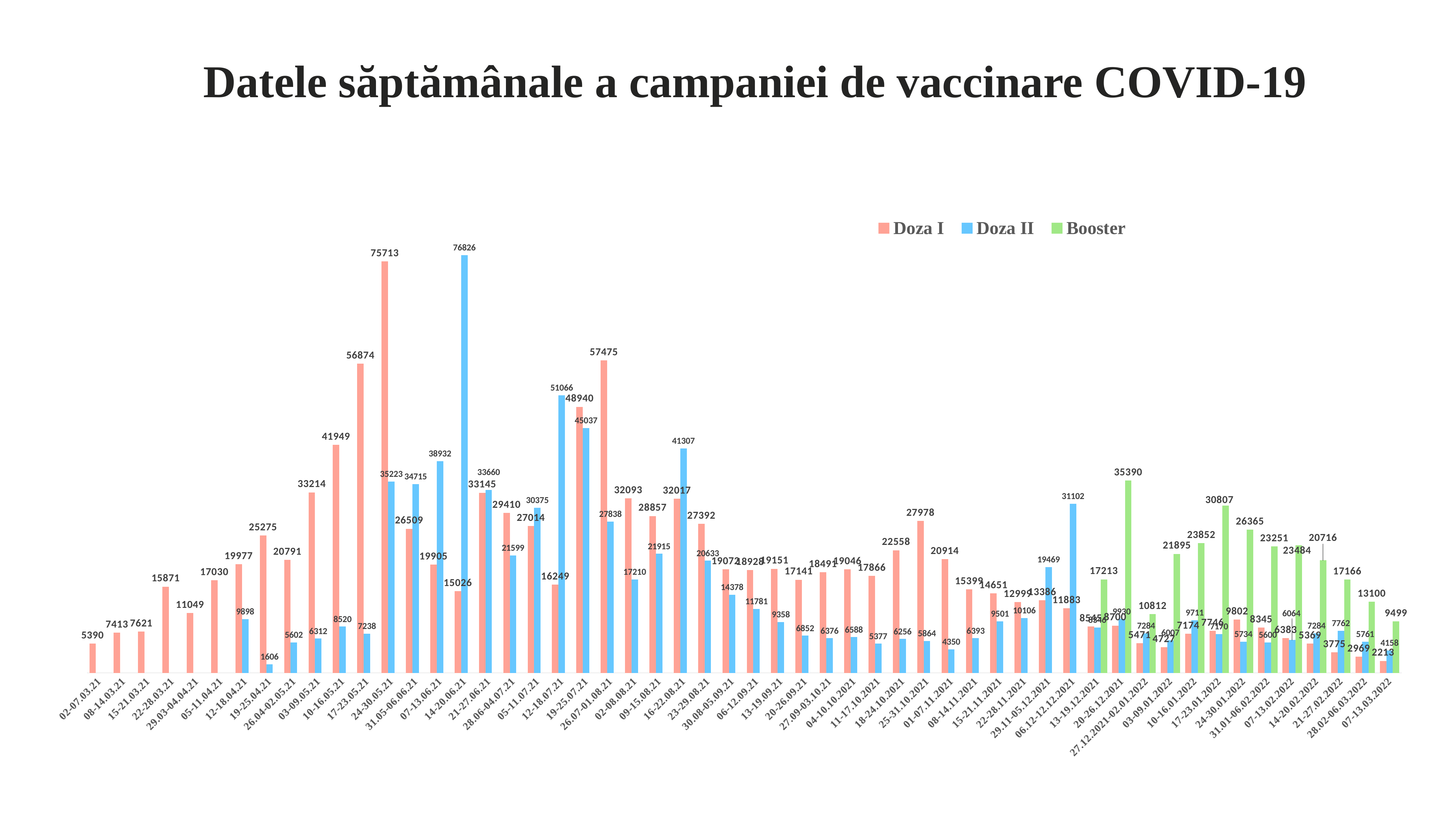
What is the Doza I value for the week 24-30.05.21? 75713 What is the Booster value for the week 20-26.12.2021? 35390 What is the title of the chart? Datele săptămânale a campaniei de vaccinare COVID-19 What type of chart is shown on the slide? bar chart How many series does the legend list? 3 In which week is the Doza I value lowest? 07-13.03.2022 What is the difference between the Doza I and Doza II values for the week 19-25.07.21? 3903 In which week is the Booster value highest? 20-26.12.2021 In which week is the Doza I value highest? 24-30.05.21 What is the Doza II value for the week 14-20.06.21? 76826 Which is larger for the week 16-22.08.21: Doza I or Doza II? Doza II What is the Booster value for the week 17-23.01.2022? 30807